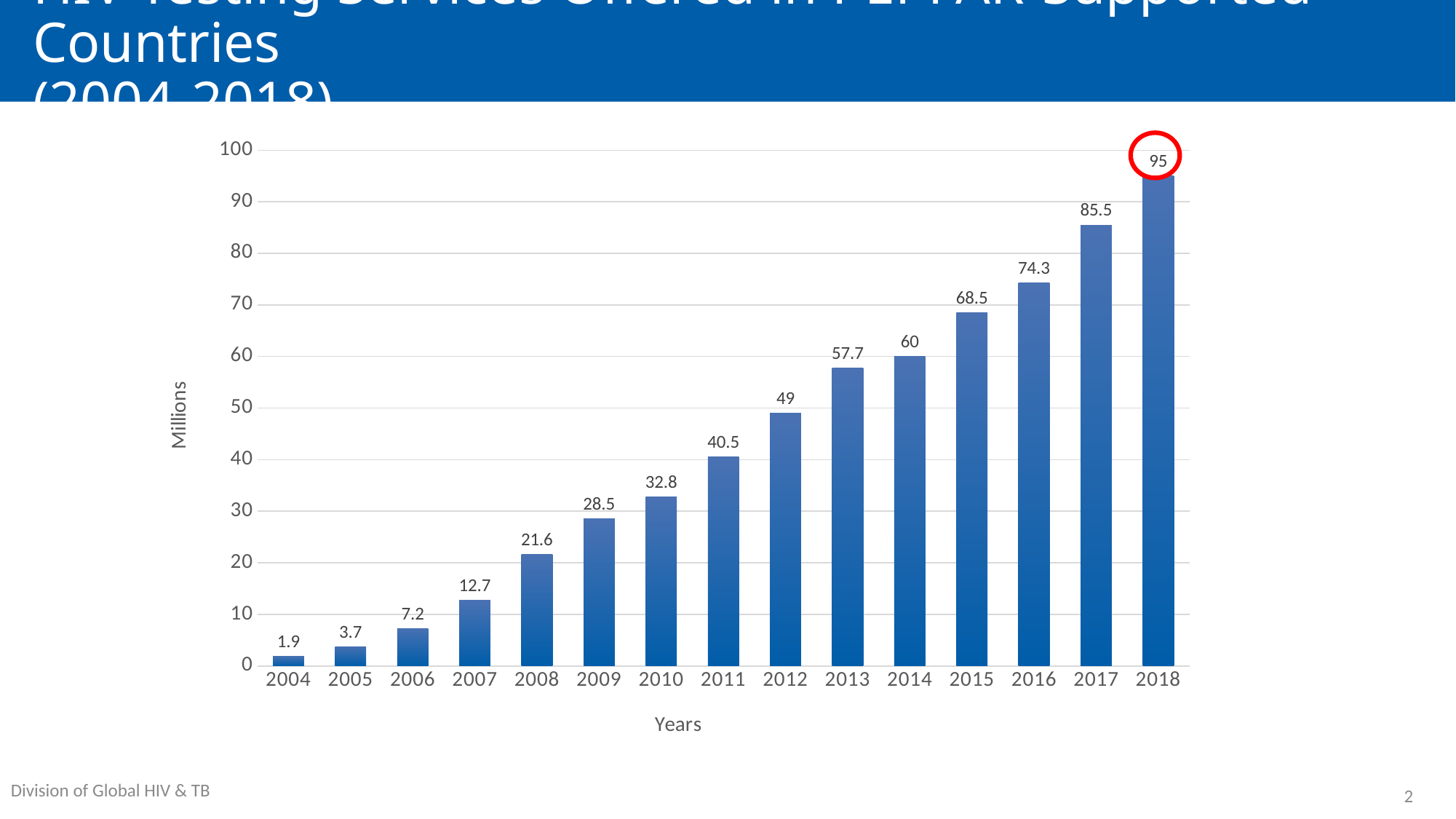
Do the values rise or fall from 2004 to 2018? rise What is the difference between the values for 2014 and 2013? 2.3 Is the value for 2015 greater or less than 60? greater What is the difference between the values for 2018 and 2017? 9.5 What is the value for 2018? 95 What is the value for 2010? 32.8 Which is larger, the value for 2012 or the value for 2011? 2012 What is the value for 2004? 1.9 Which year has the lowest value? 2004 What kind of chart is shown on the slide? bar chart How many years are shown on the x axis? 15 Which year has the highest value? 2018